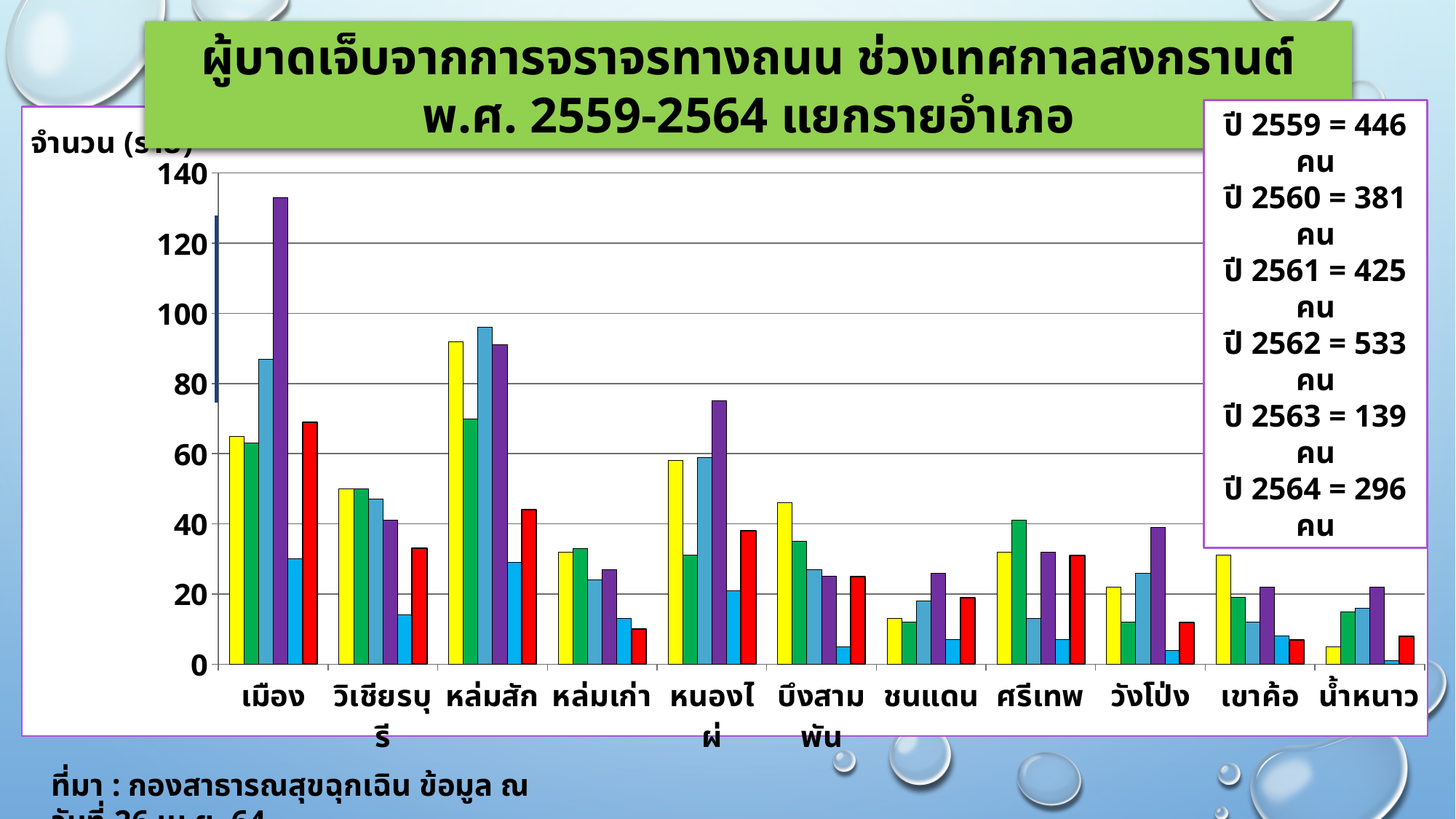
What kind of chart is shown on the slide? bar chart Which is larger: the purple bar for เมือง or the purple bar for หล่มสัก? เมือง How many districts (categories) are shown along the x axis? 11 According to the text box on the slide, what is the total for ปี 2562? 533 คน Is the value of the purple bar for หนองไผ่ greater or less than 60? greater Is the value of the purple bar for เมือง greater or less than 120? greater Is the value of the yellow bar for หล่มสัก greater or less than 80? greater Which is larger: the green bar for ศรีเทพ or the green bar for วังโป่ง? ศรีเทพ Which district has the shortest bar in the chart? น้ำหนาว Which district has the tallest bar in the chart? เมือง How many bars are plotted for each district? 6